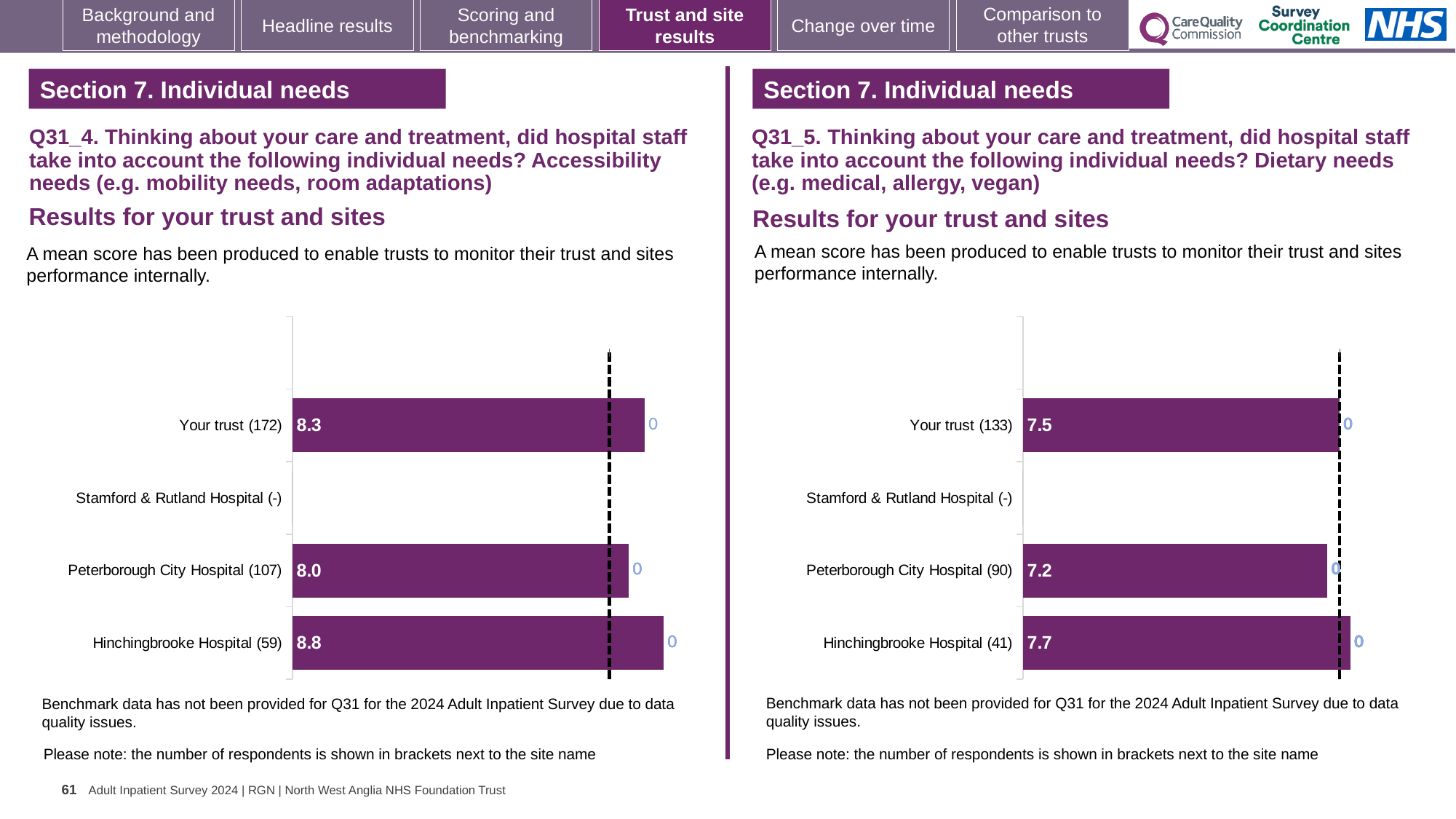
In the Q31_5 chart (right), which site with a plotted bar has the lowest mean score? Peterborough City Hospital (90) In the Q31_4 chart (left), what is the difference between the scores for Hinchingbrooke Hospital (59) and Peterborough City Hospital (107)? 0.8 In the Q31_4 chart (left), what is the mean score for Hinchingbrooke Hospital (59)? 8.8 In the Q31_4 chart (left), what is the mean score for Your trust (172)? 8.3 In the Q31_5 chart (right), what is the mean score for Your trust (133)? 7.5 In the Q31_5 chart (right), which is larger: the score for Hinchingbrooke Hospital (41) or Your trust (133)? Hinchingbrooke Hospital (41) What kind of chart is used in the Q31_5 chart (right)? Bar chart In the Q31_5 chart (right), what is the difference between the scores for Hinchingbrooke Hospital (41) and Your trust (133)? 0.2 In the Q31_4 chart (left), which site has the highest mean score? Hinchingbrooke Hospital (59) In the Q31_5 chart (right), what is the mean score for Peterborough City Hospital (90)? 7.2 In the Q31_4 chart (left), which site has no bar plotted? Stamford & Rutland Hospital (-) How many categories are listed on the y axis of the Q31_4 chart (left)? 4